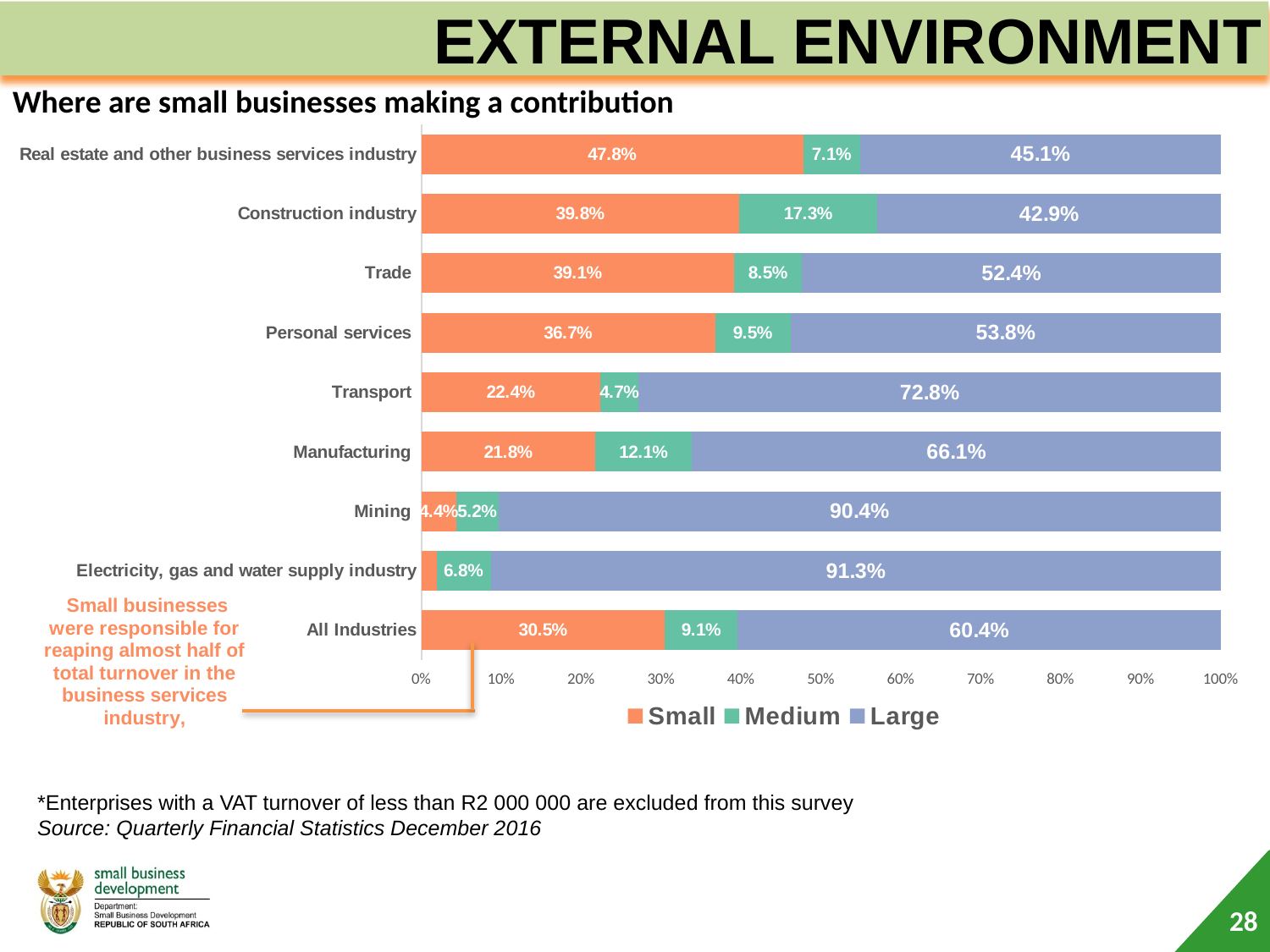
Which industry has the lowest Small share among those with a printed Small value? Mining What is the Medium share for the Construction industry? 17.3% How many industry categories are shown on the chart? 9 What is the total of the Small and Medium shares for the Construction industry? 57.1% What is the Small share for All Industries? 30.5% How many series does the legend list? 3 Which is larger: the Medium share for Trade or the Medium share for Personal services? Personal services What is the Large share for Mining? 90.4% Which industry has the highest Large share? Electricity, gas and water supply industry What kind of chart is shown on the slide? Stacked bar chart What is the difference between the Large share for Transport and the Large share for Manufacturing? 6.7% What is the Small share for the Real estate and other business services industry? 47.8%